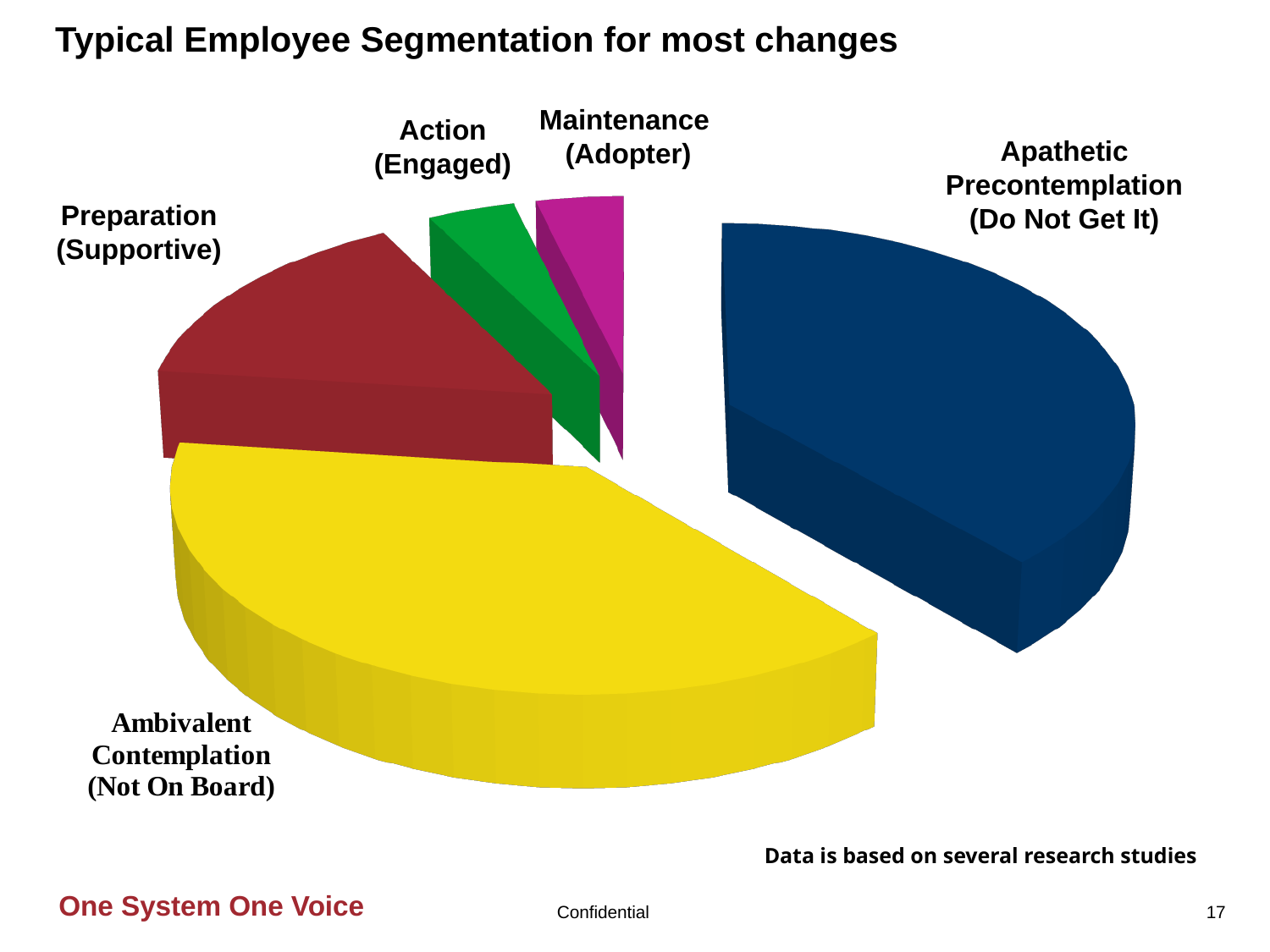
What is the title of the slide containing the pie chart? Typical Employee Segmentation for most changes Which slice is larger: Apathetic Precontemplation (Do Not Get It) or Preparation (Supportive)? Apathetic Precontemplation (Do Not Get It) What colour is the Apathetic Precontemplation (Do Not Get It) slice? Dark blue Which slice is larger: Preparation (Supportive) or Action (Engaged)? Preparation (Supportive) What kind of chart is shown on the slide? Pie chart How many slices does the pie chart have? 5